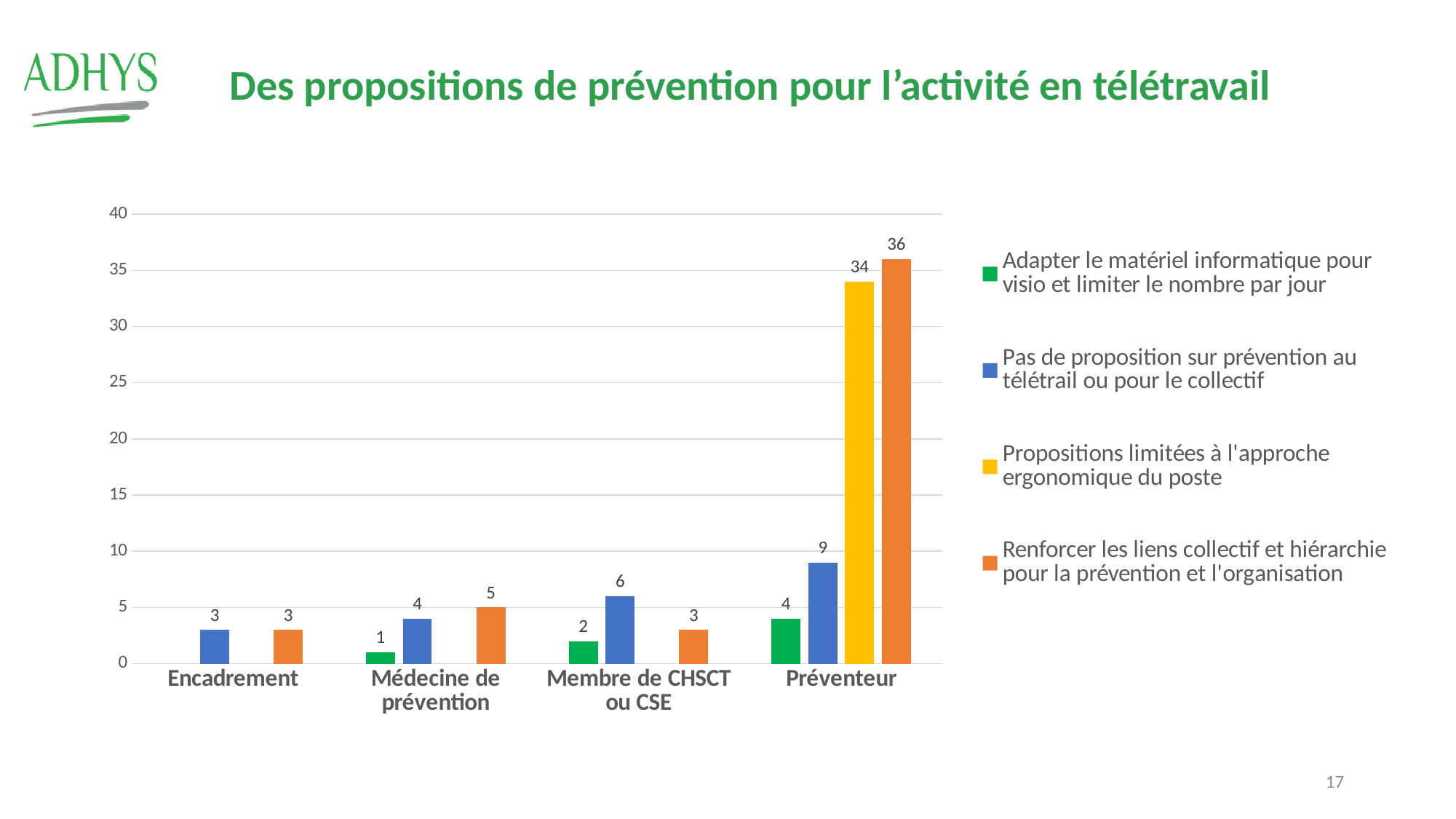
What is the value for "Propositions limitées à l'approche ergonomique du poste" in the Préventeur category? 34 What is the value for "Adapter le matériel informatique pour visio et limiter le nombre par jour" in the Médecine de prévention category? 1 How many categories are shown on the x axis? 4 Which category has the lowest value for "Renforcer les liens collectif et hiérarchie pour la prévention et l'organisation"? Encadrement and Membre de CHSCT ou CSE (both 3) What kind of chart is shown on the slide? Bar chart What is the difference between the "Renforcer les liens collectif et hiérarchie" value and the "Propositions limitées à l'approche ergonomique du poste" value in the Préventeur category? 2 What is the value for "Renforcer les liens collectif et hiérarchie pour la prévention et l'organisation" in the Préventeur category? 36 What is the value for "Pas de proposition sur prévention au télétrail ou pour le collectif" in the Membre de CHSCT ou CSE category? 6 Is the value for "Propositions limitées à l'approche ergonomique du poste" in the Préventeur category greater or less than 30? greater Which category has the highest value for "Pas de proposition sur prévention au télétrail ou pour le collectif"? Préventeur How many series does the legend list? 4 In the Médecine de prévention category, which is larger: "Pas de proposition sur prévention au télétrail ou pour le collectif" or "Renforcer les liens collectif et hiérarchie pour la prévention et l'organisation"? Renforcer les liens collectif et hiérarchie pour la prévention et l'organisation